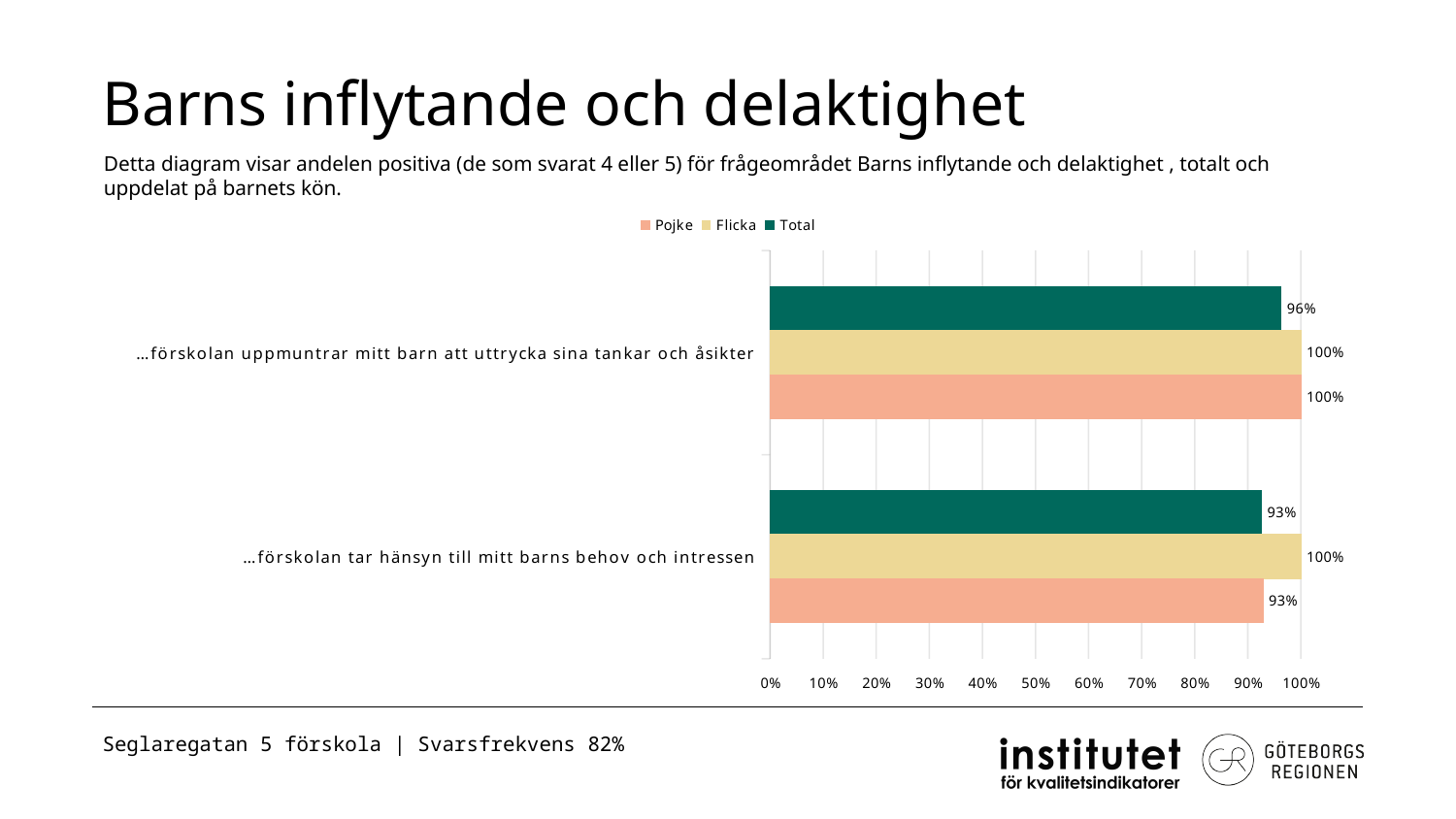
What kind of chart is shown on the slide? Bar chart For "…förskolan tar hänsyn till mitt barns behov och intressen", which is larger, the Flicka value or the Pojke value? Flicka What is the Total value for "…förskolan tar hänsyn till mitt barns behov och intressen"? 93% What is the difference between the Total values of the two categories? 3% What is the Total value for "…förskolan uppmuntrar mitt barn att uttrycka sina tankar och åsikter"? 96% How many categories are shown on the chart? 2 What is the Pojke value for "…förskolan tar hänsyn till mitt barns behov och intressen"? 93% Which category has the lower Total value? …förskolan tar hänsyn till mitt barns behov och intressen What is the Flicka value for "…förskolan tar hänsyn till mitt barns behov och intressen"? 100% How many series does the legend list? 3 What is the difference between the Flicka and Pojke values for "…förskolan tar hänsyn till mitt barns behov och intressen"? 7% What is the Pojke value for "…förskolan uppmuntrar mitt barn att uttrycka sina tankar och åsikter"? 100%